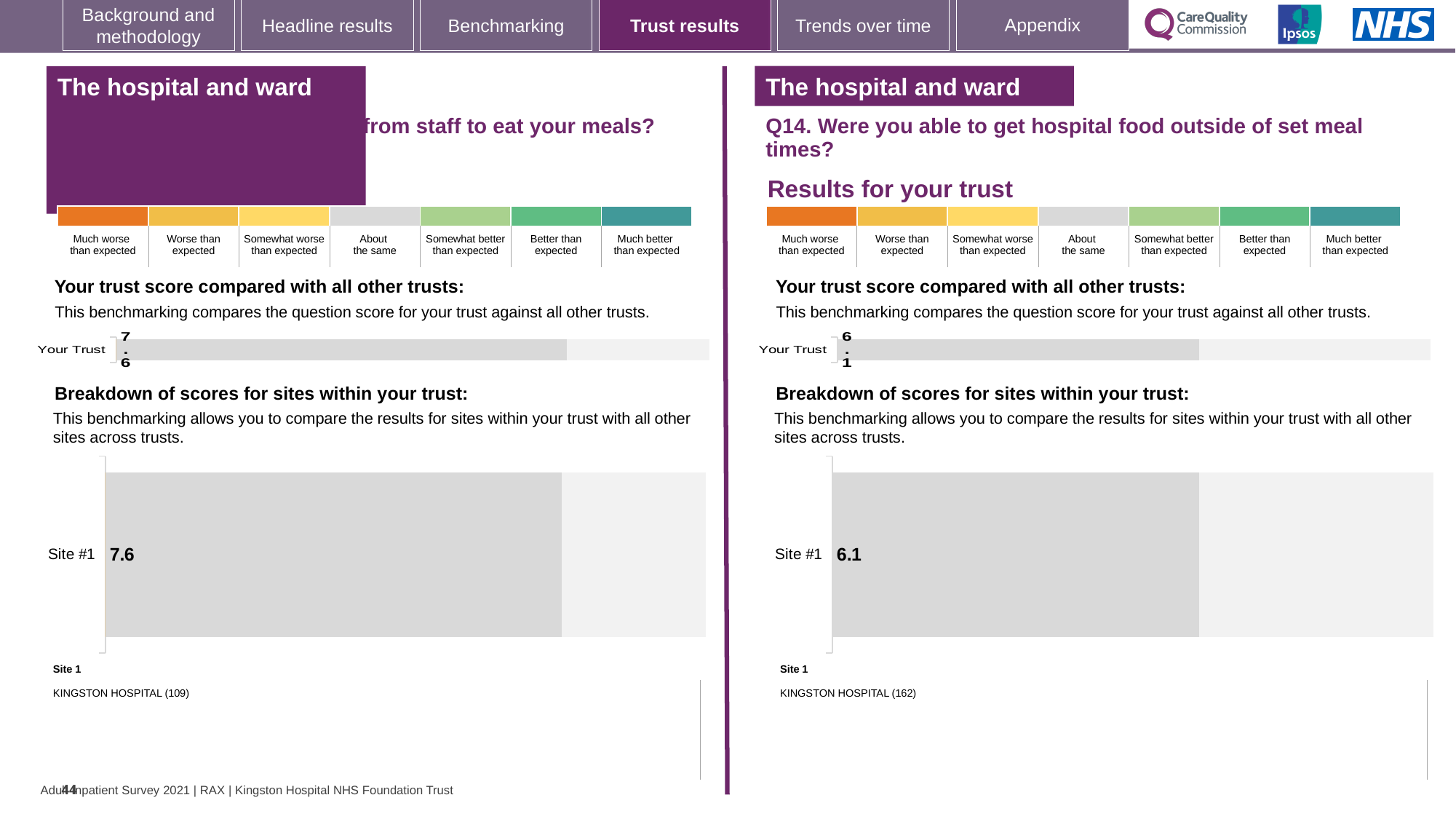
In the left-hand 'Breakdown of scores for sites within your trust' chart, what is the score for Site #1? 7.6 What kind of chart is used to show the Site #1 score in the right-hand 'Breakdown of scores for sites within your trust' section? bar chart In the right-hand 'Breakdown of scores for sites within your trust' chart (Q14), what is the score for Site #1? 6.1 How many sites are plotted in the right-hand 'Breakdown of scores for sites within your trust' chart (Q14)? 1 In the left-hand breakdown chart, what number appears in parentheses after KINGSTON HOSPITAL for Site 1? 109 On the left-hand slide half, what score is shown for 'Your Trust' in the trust score chart? 7.6 On the right-hand slide half (Q14), what score is shown for 'Your Trust' in the trust score chart? 6.1 Which Site #1 score is larger: the one in the left-hand breakdown chart or the one in the right-hand breakdown chart (Q14)? the left-hand chart What is the difference between the Site #1 score in the left-hand breakdown chart (7.6) and the Site #1 score in the right-hand breakdown chart (6.1)? 1.5 In the right-hand breakdown chart (Q14), which hospital is listed as Site 1? KINGSTON HOSPITAL (162) How many bars are plotted in the left-hand 'Your trust score compared with all other trusts' chart? 1